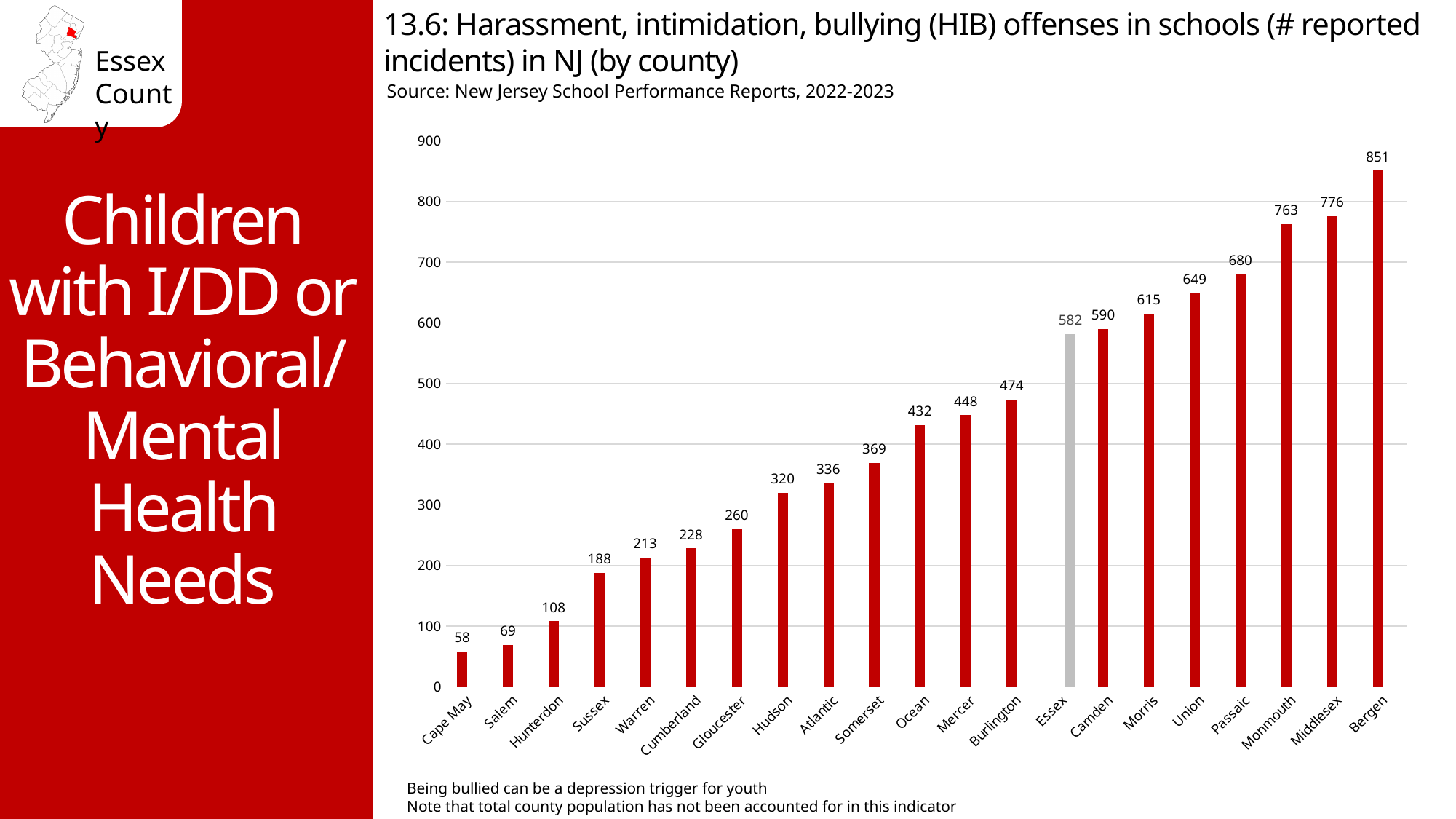
What is the value shown for Hudson County? 320 Which county's bar is coloured grey instead of red? Essex Do the values rise or fall moving from left to right along the x axis? rise Which county has the highest number of reported HIB incidents? Bergen What is the difference between the values for Camden and Essex? 8 Which county has the lowest number of reported HIB incidents? Cape May How many reported HIB incidents does the chart show for Essex County? 582 What is the difference between the values for Bergen and Essex? 269 How many counties are shown on the chart? 21 Which county has more reported incidents, Monmouth or Passaic? Monmouth Is the value for Ocean County greater or less than 400? greater What type of chart is used on this slide? bar chart